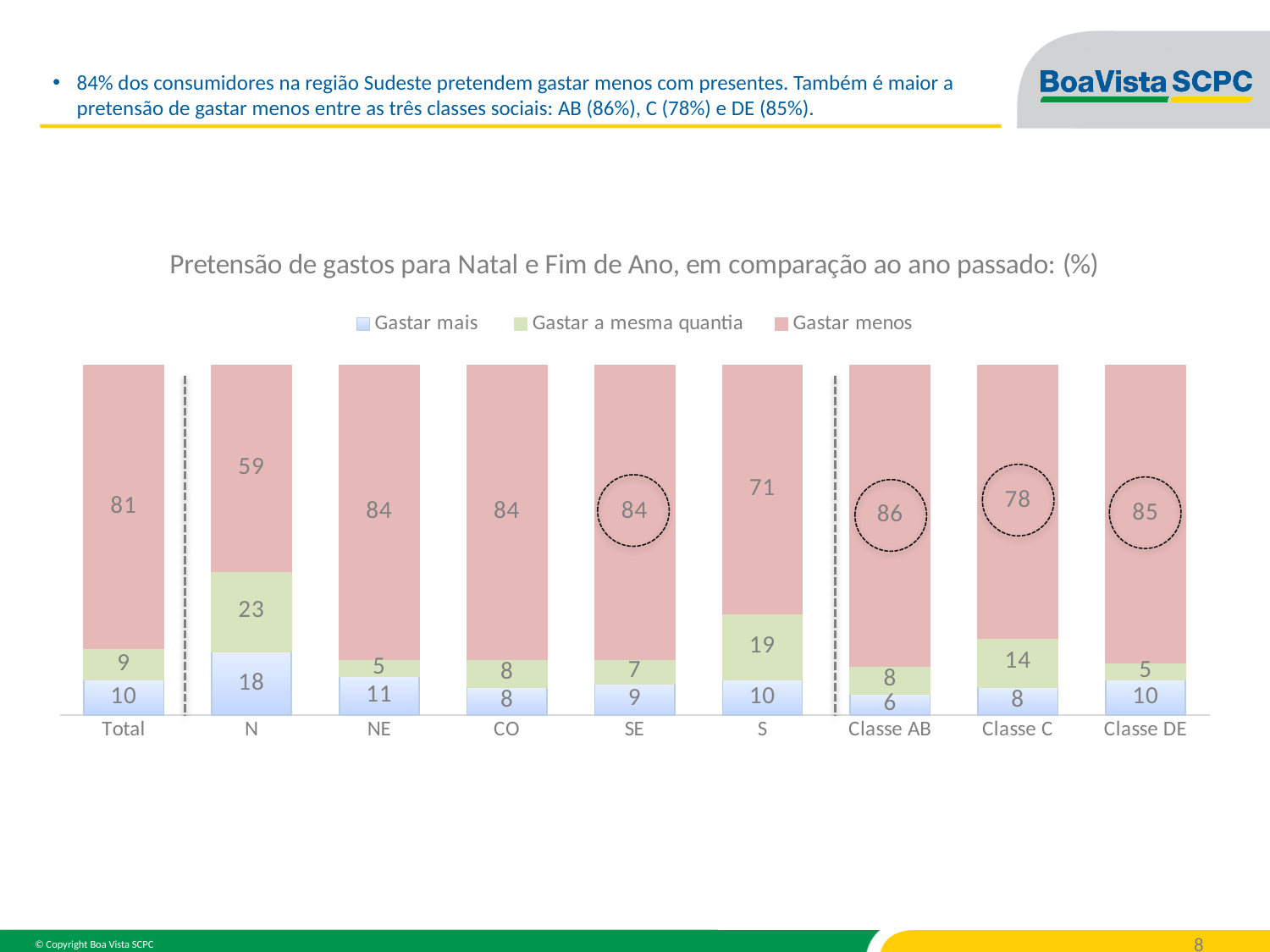
What is the value of "Gastar menos" for Classe AB? 86 Which category has the highest value for "Gastar menos"? Classe AB Which category has the lowest value for "Gastar menos"? N What is the total of the stacked bar for S? 100 Which is larger, the "Gastar a mesma quantia" value for S or for Classe C? S How many categories are shown on the x axis? 9 What is the difference between the "Gastar menos" values for Classe AB and Classe C? 8 What kind of chart is shown on the slide? Stacked bar chart How many series does the legend list? 3 What is the title of the chart? Pretensão de gastos para Natal e Fim de Ano, em comparação ao ano passado: (%) What is the value of "Gastar mais" for NE? 11 What is the value of "Gastar a mesma quantia" for N? 23